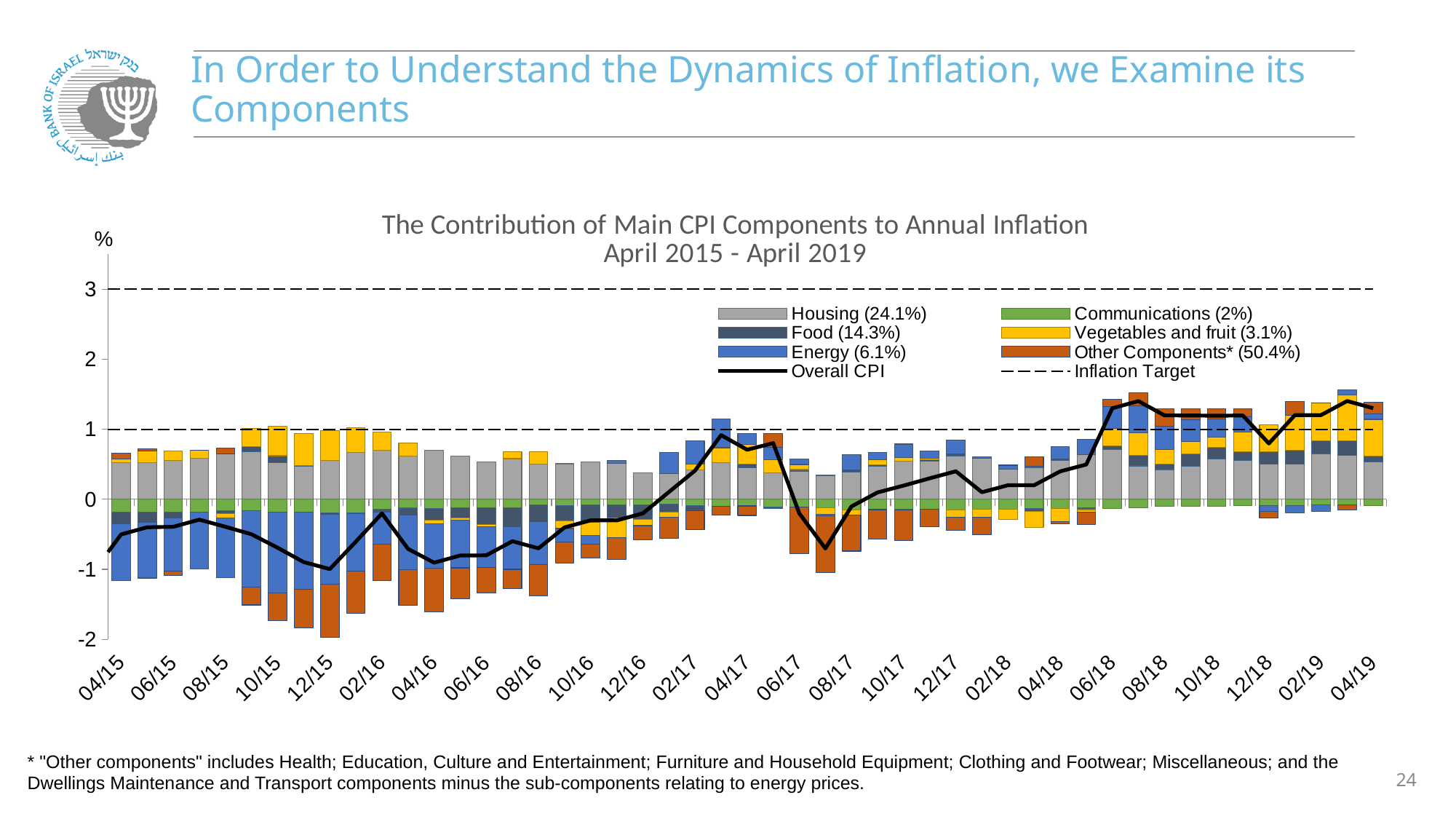
Is the Overall CPI value at 12/15 greater or less than 0? less At which two values are the Inflation Target dashed lines drawn? 1 and 3 Which is higher, the Overall CPI at 12/15 or at 12/18? 12/18 How many month labels are shown on the x axis? 25 Is the Overall CPI value at 04/19 greater or less than 1? greater Is the Overall CPI value at 04/15 greater or less than 0? less Which is higher, the Overall CPI at 04/15 or at 04/19? 04/19 How many series does the legend list? 8 What kind of chart is shown on the slide? Stacked bar chart with a line Does the Overall CPI line rise or fall from 12/15 to 04/19? rise What weight is shown for Housing in the legend? 24.1%